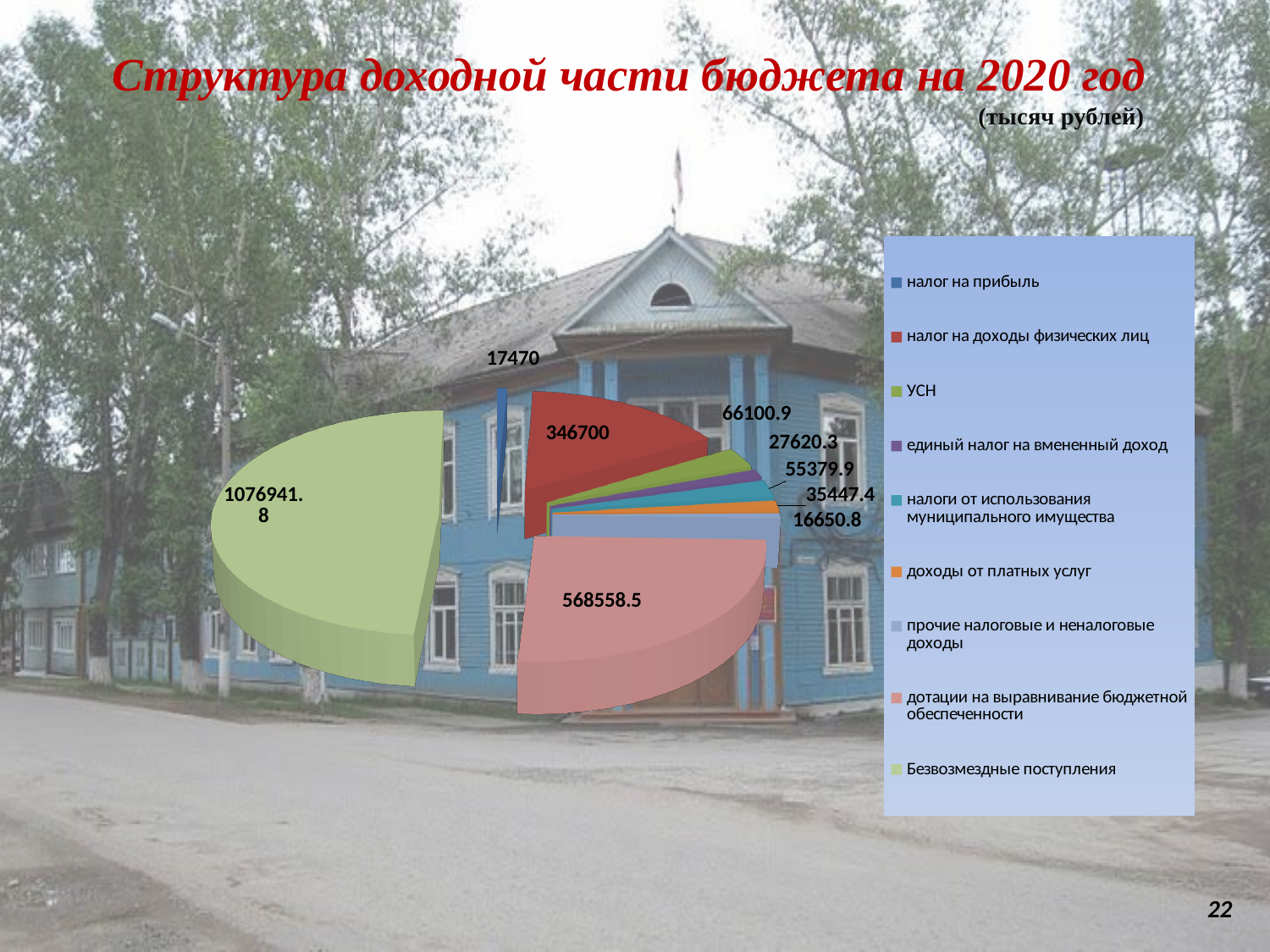
What is the value for Безвозмездные поступления? 1076941.8 What unit is stated under the chart title? тысяч рублей What is the difference between the values for Безвозмездные поступления and дотации на выравнивание бюджетной обеспеченности? 508383.3 What is the value for УСН? 66100.9 What is the value for налог на доходы физических лиц? 346700 How many entries does the legend of the pie chart list? 9 Which category has the largest slice of the pie? Безвозмездные поступления What is the value for налог на прибыль? 17470 What is the value for дотации на выравнивание бюджетной обеспеченности? 568558.5 Which category has the smallest slice of the pie? прочие налоговые и неналоговые доходы What kind of chart is shown on the slide? pie chart Which is larger: налоги от использования муниципального имущества or доходы от платных услуг? налоги от использования муниципального имущества